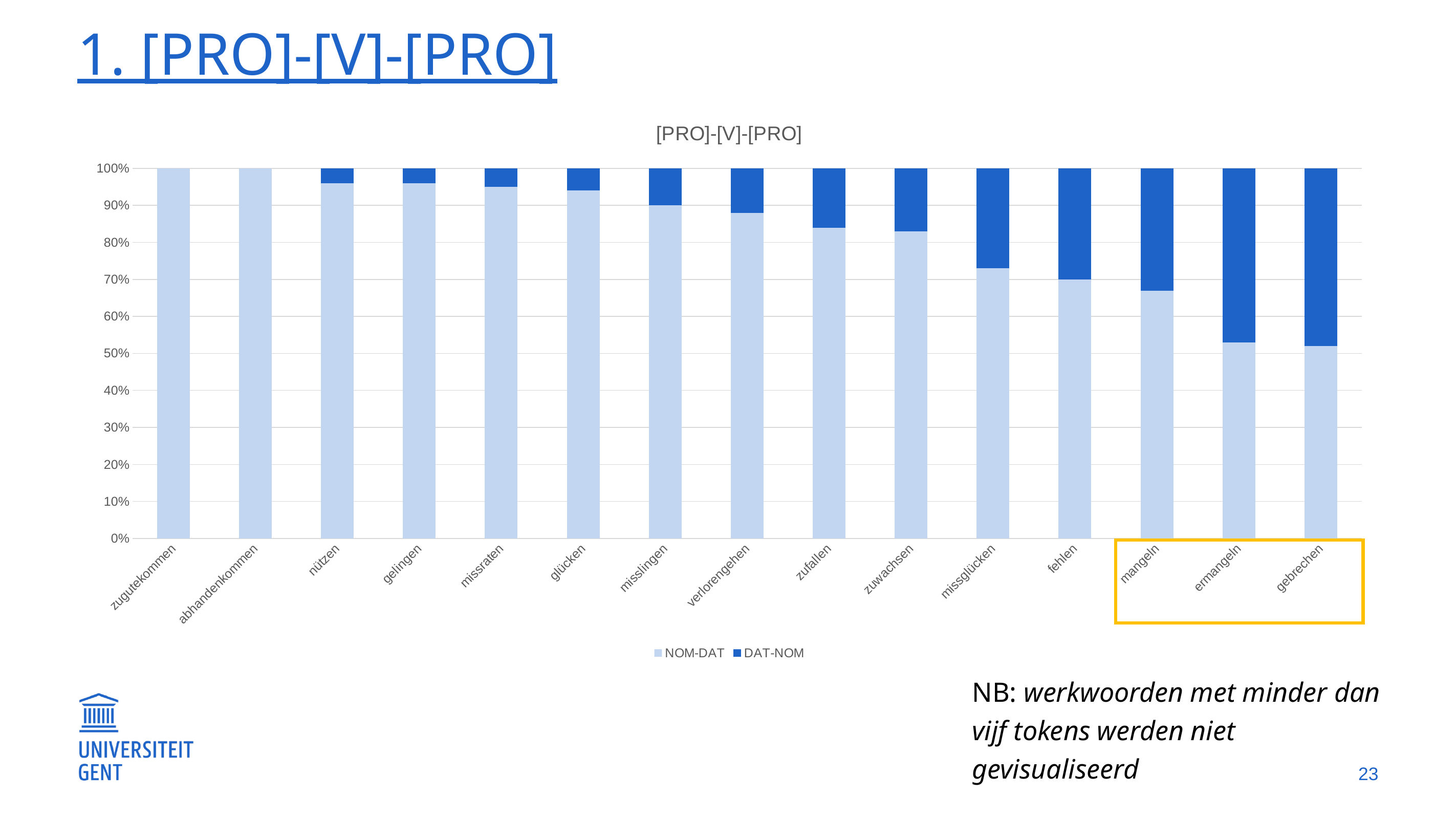
Which verb has the largest DAT-NOM share? gebrechen Which has the larger NOM-DAT share, zufallen or ermangeln? zufallen Is the NOM-DAT value for gebrechen greater or less than 60%? less Is the NOM-DAT value for nützen greater or less than 90%? greater How many verbs (categories) are shown on the x axis? 15 What kind of chart is shown on the slide? bar chart Is the NOM-DAT value for mangeln greater or less than 60%? greater How many series does the legend list? 2 What is the NOM-DAT value for zugutekommen? 100% What is the title of the chart? [PRO]-[V]-[PRO] What is the NOM-DAT value for abhandenkommen? 100% Does the NOM-DAT share rise or fall moving from left to right along the x axis? fall